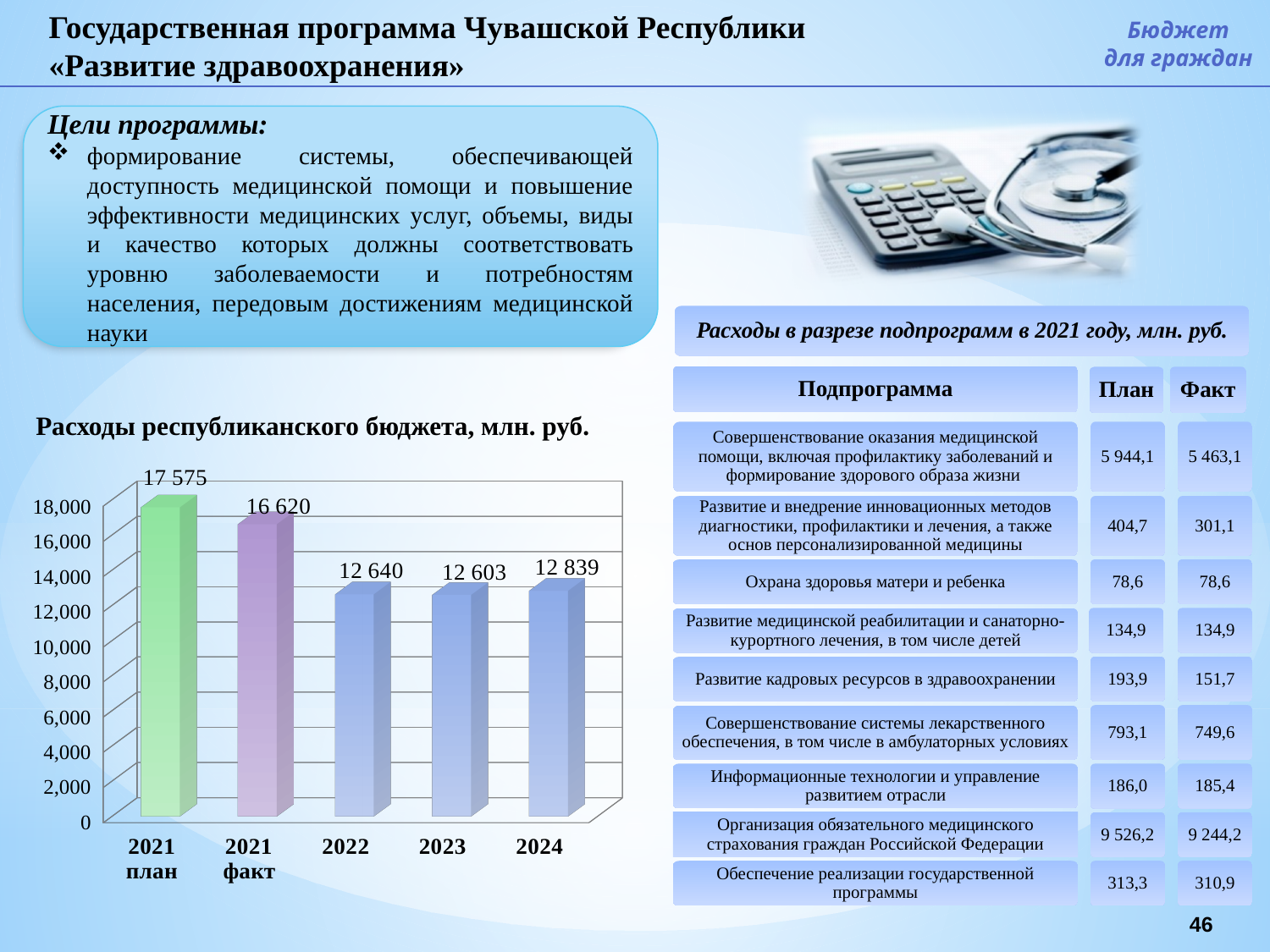
What kind of chart is 'Расходы республиканского бюджета, млн. руб.'? bar chart Which category has the highest value in the chart 'Расходы республиканского бюджета, млн. руб.'? 2021 план How many bars are shown in the chart 'Расходы республиканского бюджета, млн. руб.'? 5 What is the difference between the 2021 план and 2021 факт values in the chart 'Расходы республиканского бюджета, млн. руб.'? 955 What is the value for 2021 факт in the chart 'Расходы республиканского бюджета, млн. руб.'? 16 620 What is the value for 2024 in the chart 'Расходы республиканского бюджета, млн. руб.'? 12 839 Is the value for 2023 in the chart 'Расходы республиканского бюджета, млн. руб.' greater or less than 14,000? less What is the difference between the 2024 and 2022 values in the chart 'Расходы республиканского бюджета, млн. руб.'? 199 Which category has the lowest value in the chart 'Расходы республиканского бюджета, млн. руб.'? 2023 What is the value for 2021 план in the chart 'Расходы республиканского бюджета, млн. руб.'? 17 575 What is the title of the chart on the left side of the slide? Расходы республиканского бюджета, млн. руб. In the chart 'Расходы республиканского бюджета, млн. руб.', which is larger: the value for 2022 or the value for 2021 факт? 2021 факт